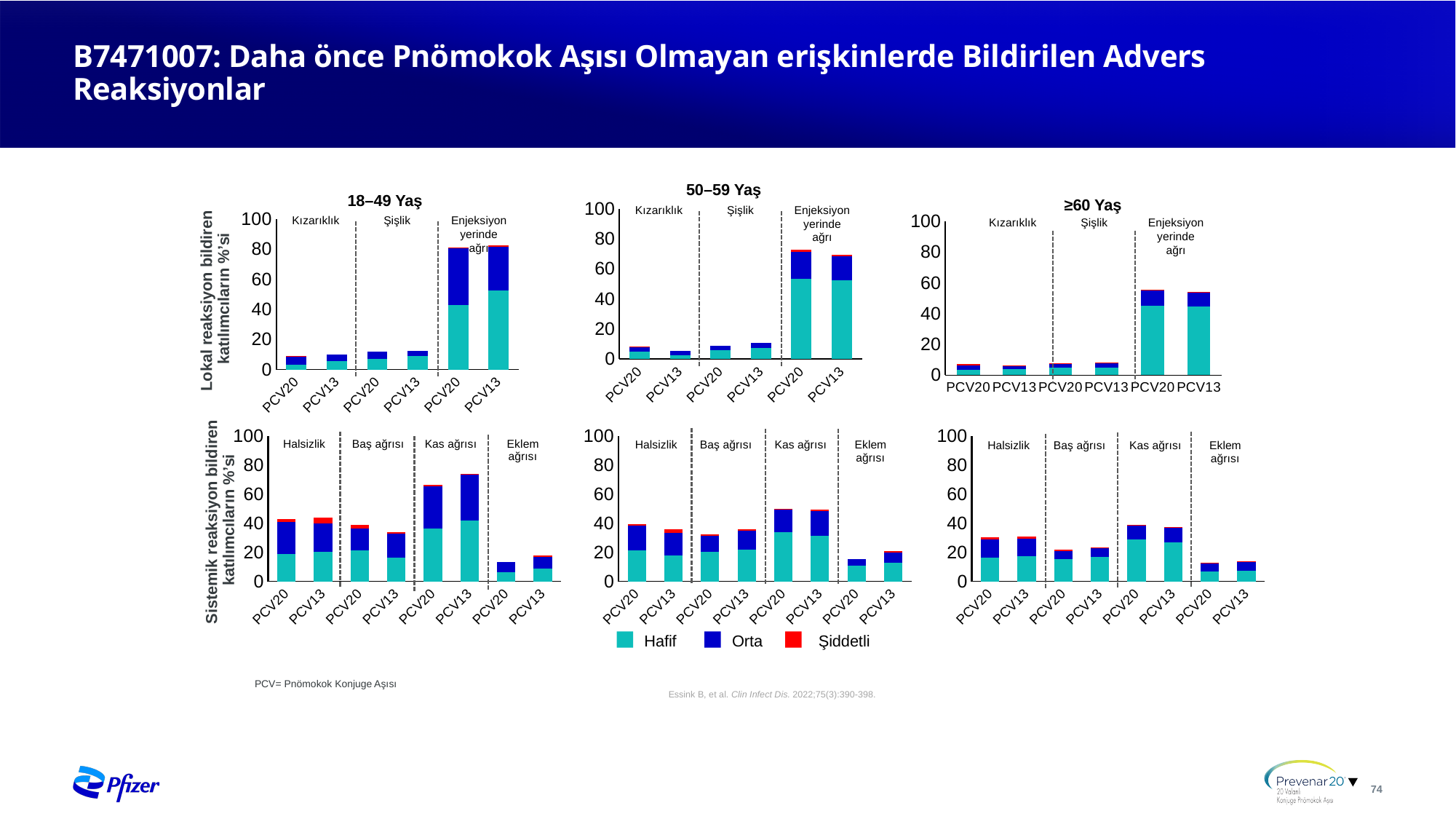
In the 18–49 Yaş systemic reaction chart (bottom left), which is larger for Kas ağrısı: PCV20 or PCV13? PCV13 In the 18–49 Yaş systemic reaction chart (bottom left), which bar is the highest? Kas ağrısı PCV13 How many series does the legend list for the charts on this slide? 3 In the ≥60 Yaş local reaction chart (top right), is the value for Kızarıklık PCV20 greater or less than 20? less In the 18–49 Yaş systemic reaction chart (bottom left), which bar is the lowest? Eklem ağrısı PCV20 In the 18–49 Yaş local reaction chart (top left), is the value for Enjeksiyon yerinde ağrı PCV20 greater or less than 60? greater How many bars are plotted in the 18–49 Yaş systemic reaction chart (bottom left)? 8 In the 50–59 Yaş systemic reaction chart (bottom middle), is the value for Baş ağrısı PCV20 greater or less than 40? less What are the three legend entries shown below the charts? Hafif, Orta, Şiddetli In the 50–59 Yaş systemic reaction chart (bottom middle), which bar is the lowest? Eklem ağrısı PCV20 What kind of chart is used for the 18–49 Yaş local reaction panel (top left)? Stacked bar chart